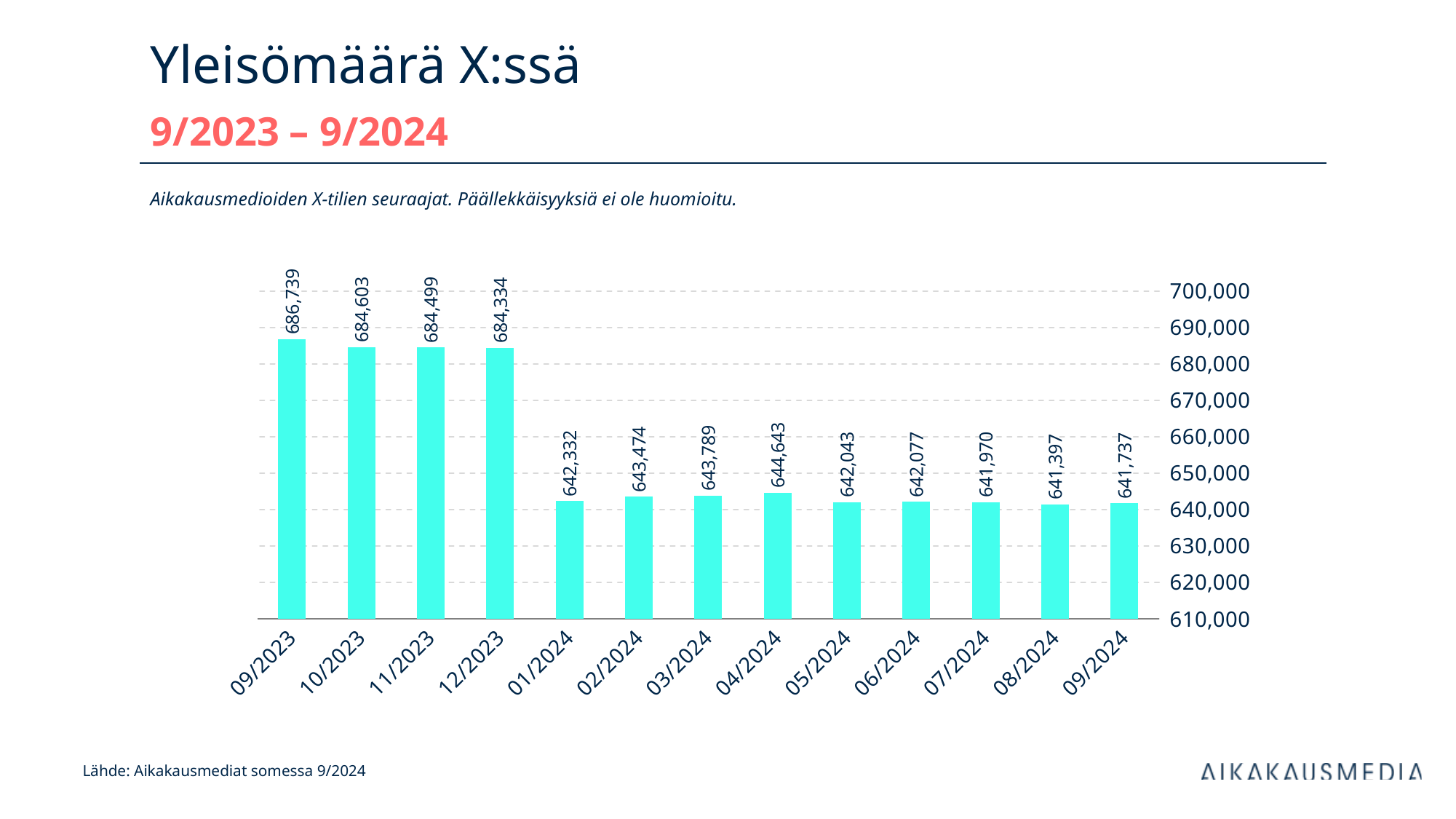
What kind of chart is shown on the slide? bar chart What is the difference between the values for 09/2023 and 09/2024? 45,002 Is the value for 02/2024 greater or less than 650,000? less What is the value for 01/2024? 642,332 What is the value for 09/2024? 641,737 Which month has the lowest value? 08/2024 Which is larger, the value for 04/2024 or the value for 05/2024? 04/2024 What is the value for 09/2023? 686,739 Which month has the highest value? 09/2023 How many months are shown on the x axis? 13 Do the values generally rise or fall from 09/2023 to 09/2024? fall What is the difference between the values for 12/2023 and 01/2024? 42,002